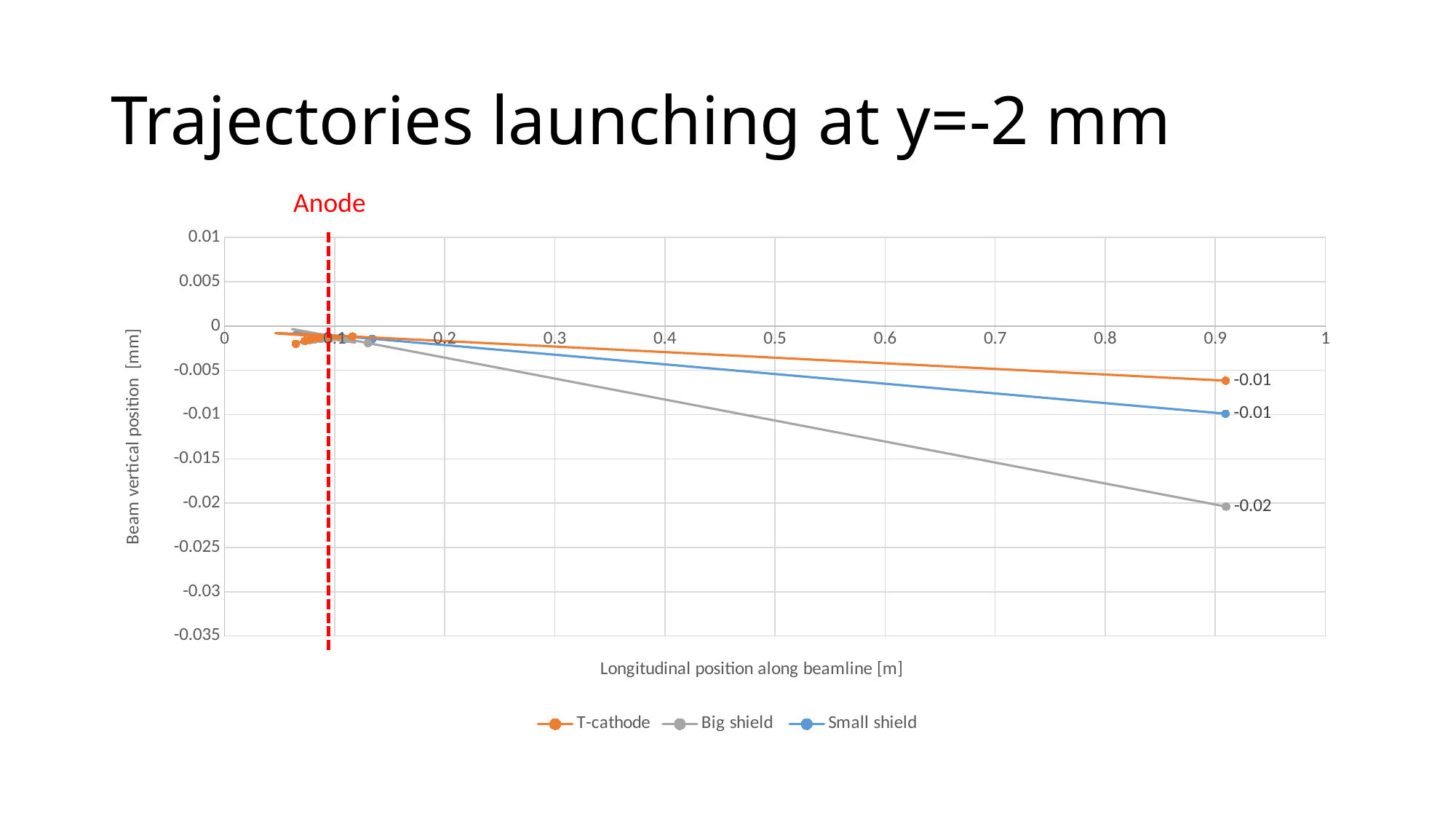
What is the labelled end value of the Big shield trajectory? -0.02 How many series does the legend list? 3 Is the end value of the Big shield trajectory greater or less than -0.015? less What kind of chart is shown on the slide? line chart What is the labelled end value of the T-cathode trajectory? -0.01 Which series stays highest (closest to 0) at the end of the beamline? T-cathode What is the labelled end value of the Small shield trajectory? -0.01 Which series are listed in the legend? T-cathode, Big shield, Small shield At the end of the beamline, which is lower: the Big shield trajectory or the Small shield trajectory? Big shield Which series reaches the lowest vertical position at the end of the beamline? Big shield What is the title of the slide's chart? Trajectories launching at y=-2 mm Do the trajectories rise or fall as the longitudinal position increases? fall